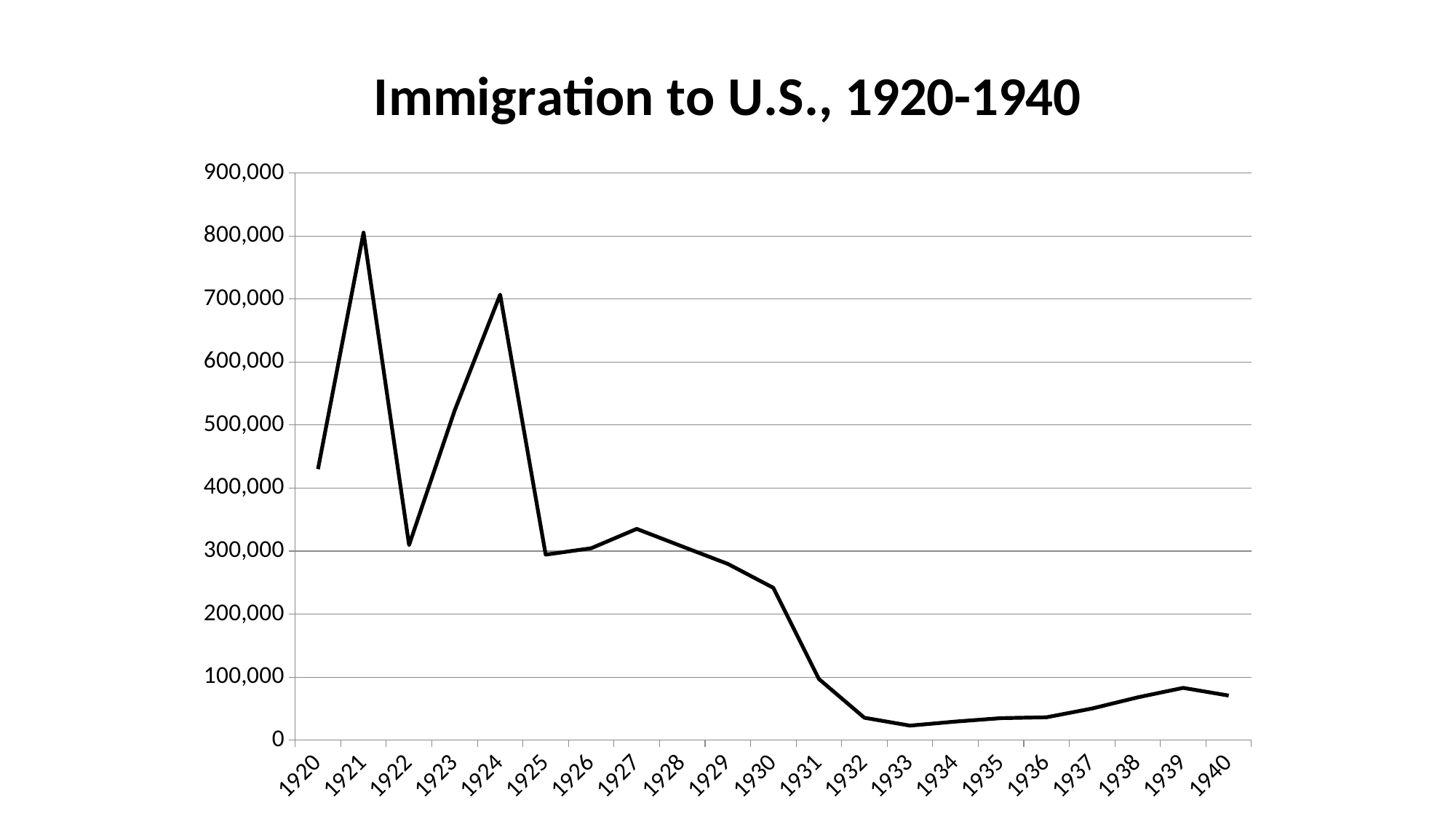
Is the value for 1921 greater or less than 700,000? greater Is the value for 1940 greater or less than 100,000? less Is the value for 1924 greater or less than 600,000? greater What kind of chart is shown on the slide? line chart How many years are plotted along the x axis? 21 Which year has the highest immigration value? 1921 What is the title of the chart? Immigration to U.S., 1920-1940 Which year has the larger value, 1920 or 1922? 1920 Do the values rise or fall from 1927 to 1933? fall Which year has the larger value, 1921 or 1924? 1921